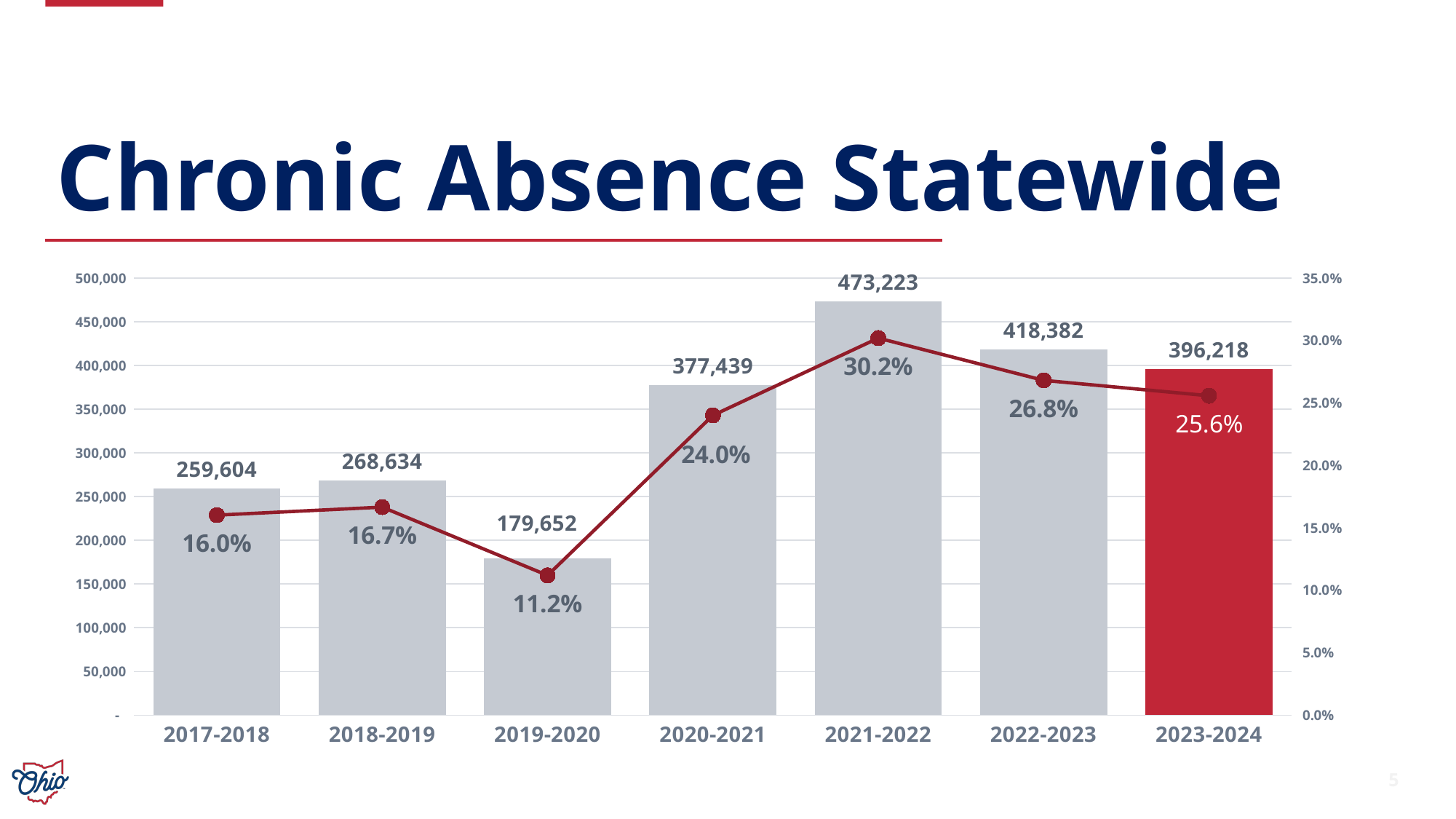
How many school years are shown on the x axis? 7 What is the difference between the bar values for 2021-2022 and 2022-2023? 54,841 Does the percentage on the line rise or fall from 2021-2022 to 2023-2024? Fall What percentage is shown on the line for 2017-2018? 16.0% What is the bar value for 2021-2022? 473,223 What percentage is shown on the line for 2019-2020? 11.2% What kind of chart is this? Combined bar and line chart What is the bar value for 2023-2024? 396,218 Which bar is coloured red instead of grey? 2023-2024 Which school year has the highest bar value? 2021-2022 Which is larger, the bar value for 2018-2019 or for 2017-2018? 2018-2019 Which school year has the lowest percentage on the line? 2019-2020